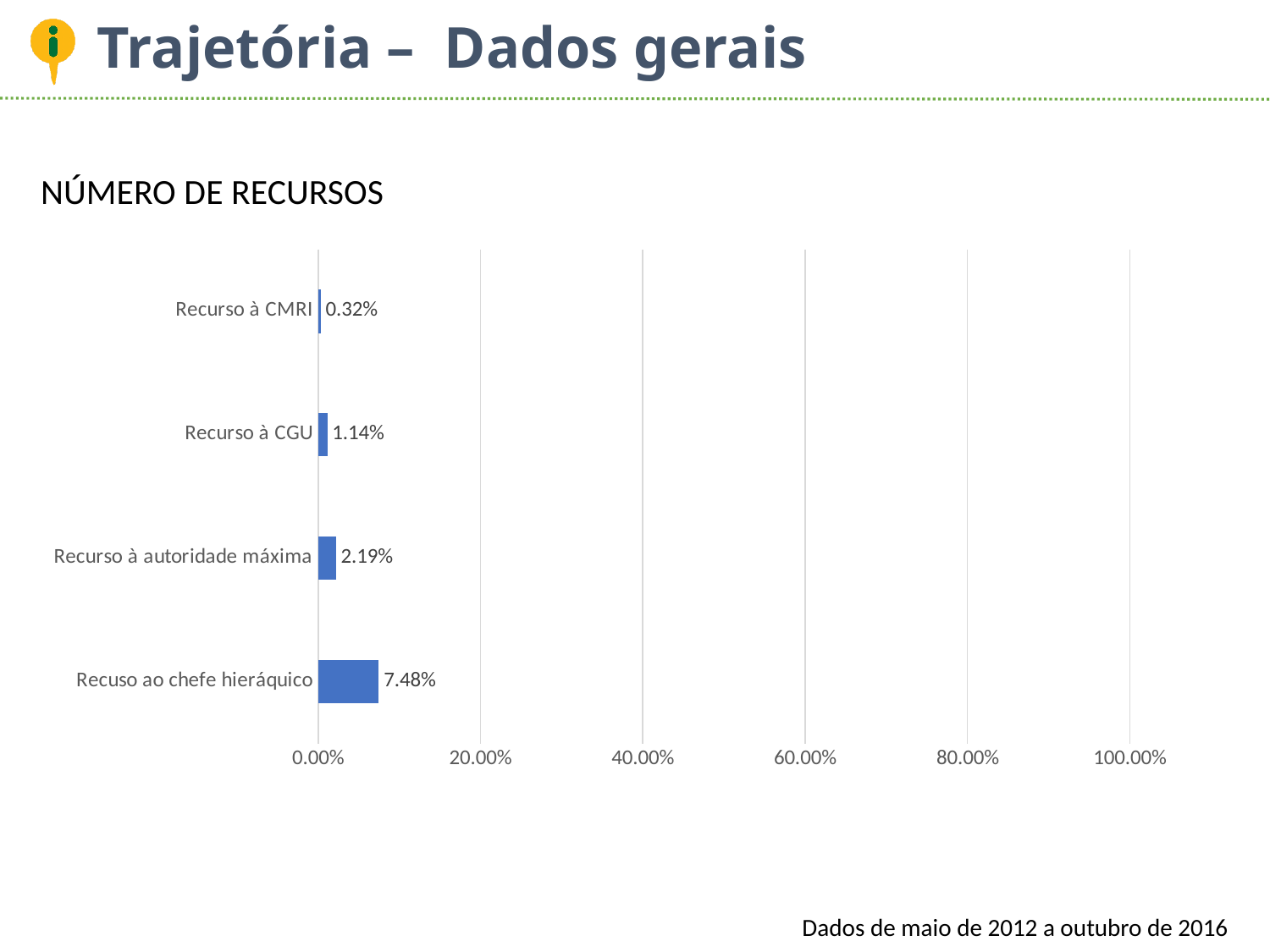
What is the difference between the values for Recuso ao chefe hieráquico and Recurso à autoridade máxima? 5.29% Which category has the highest value? Recuso ao chefe hieráquico Which is larger, the value for Recurso à CGU or the value for Recurso à CMRI? Recurso à CGU What is the value for Recurso à autoridade máxima? 2.19% What is the value for Recuso ao chefe hieráquico? 7.48% What is the title of the chart? NÚMERO DE RECURSOS Is the value for Recuso ao chefe hieráquico greater or less than 20.00%? less What kind of chart is shown on the slide? bar chart What is the value for Recurso à CGU? 1.14% Which category has the lowest value? Recurso à CMRI What is the value for Recurso à CMRI? 0.32% How many categories are shown in the chart? 4